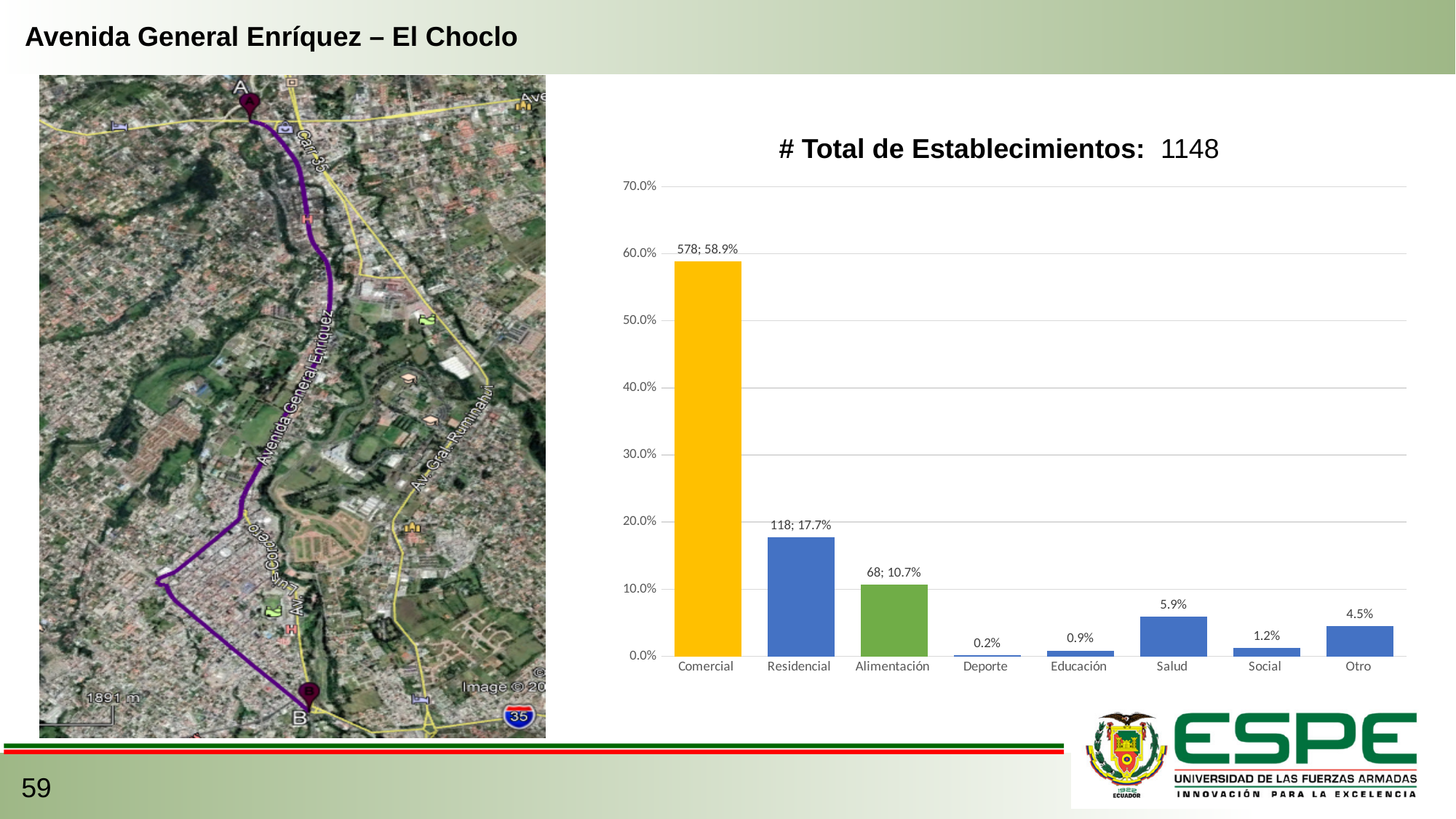
What kind of chart is this? Bar chart What total number of establishments is stated above the chart? 1148 What is the difference in percentage points between Residencial and Alimentación? 7.0% What percentage is shown for Salud? 5.9% Which category has the highest value? Comercial Which is larger, Salud or Otro? Salud What percentage is shown for Deporte? 0.2% Which category has the lowest value? Deporte How many categories are shown on the x axis? 8 What count is shown for Residencial? 118 What colour is the Alimentación bar? Green What percentage is shown for Comercial? 58.9%